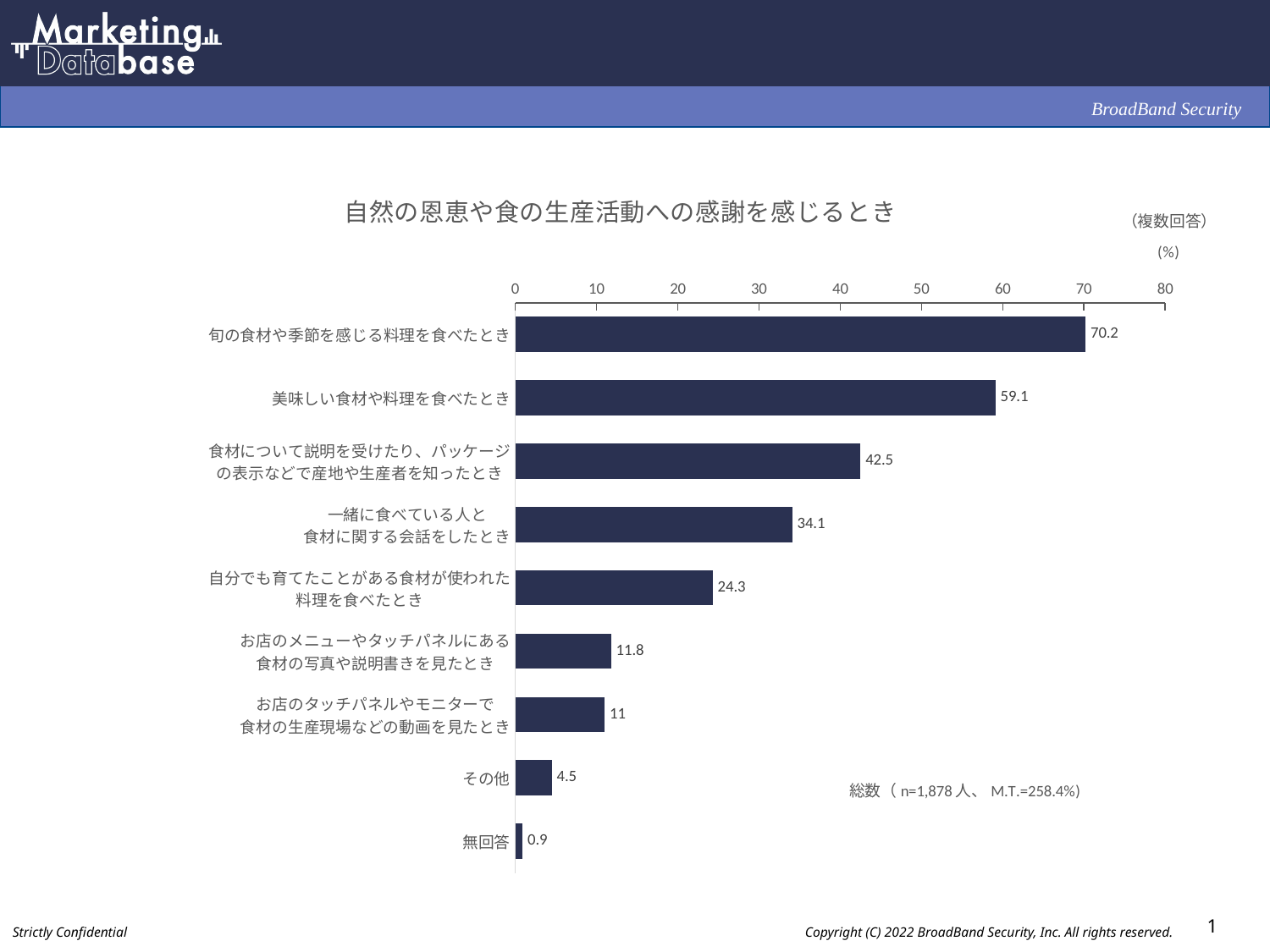
What is the difference between the values for 旬の食材や季節を感じる料理を食べたとき and 美味しい食材や料理を食べたとき? 11.1 How many categories are shown in the chart? 9 What is the value for 美味しい食材や料理を食べたとき? 59.1 What is the title of the chart? 自然の恩恵や食の生産活動への感謝を感じるとき What kind of chart is shown on the slide? Bar chart Which category has the lowest value? 無回答 Which category has the highest value? 旬の食材や季節を感じる料理を食べたとき What is the value for 一緒に食べている人と食材に関する会話をしたとき? 34.1 Which is larger, the value for 食材について説明を受けたり、パッケージの表示などで産地や生産者を知ったとき or the value for 自分でも育てたことがある食材が使われた料理を食べたとき? 食材について説明を受けたり、パッケージの表示などで産地や生産者を知ったとき What is the value for 旬の食材や季節を感じる料理を食べたとき? 70.2 What is the value for その他? 4.5 What is the sample size (n) noted on the chart? 1,878